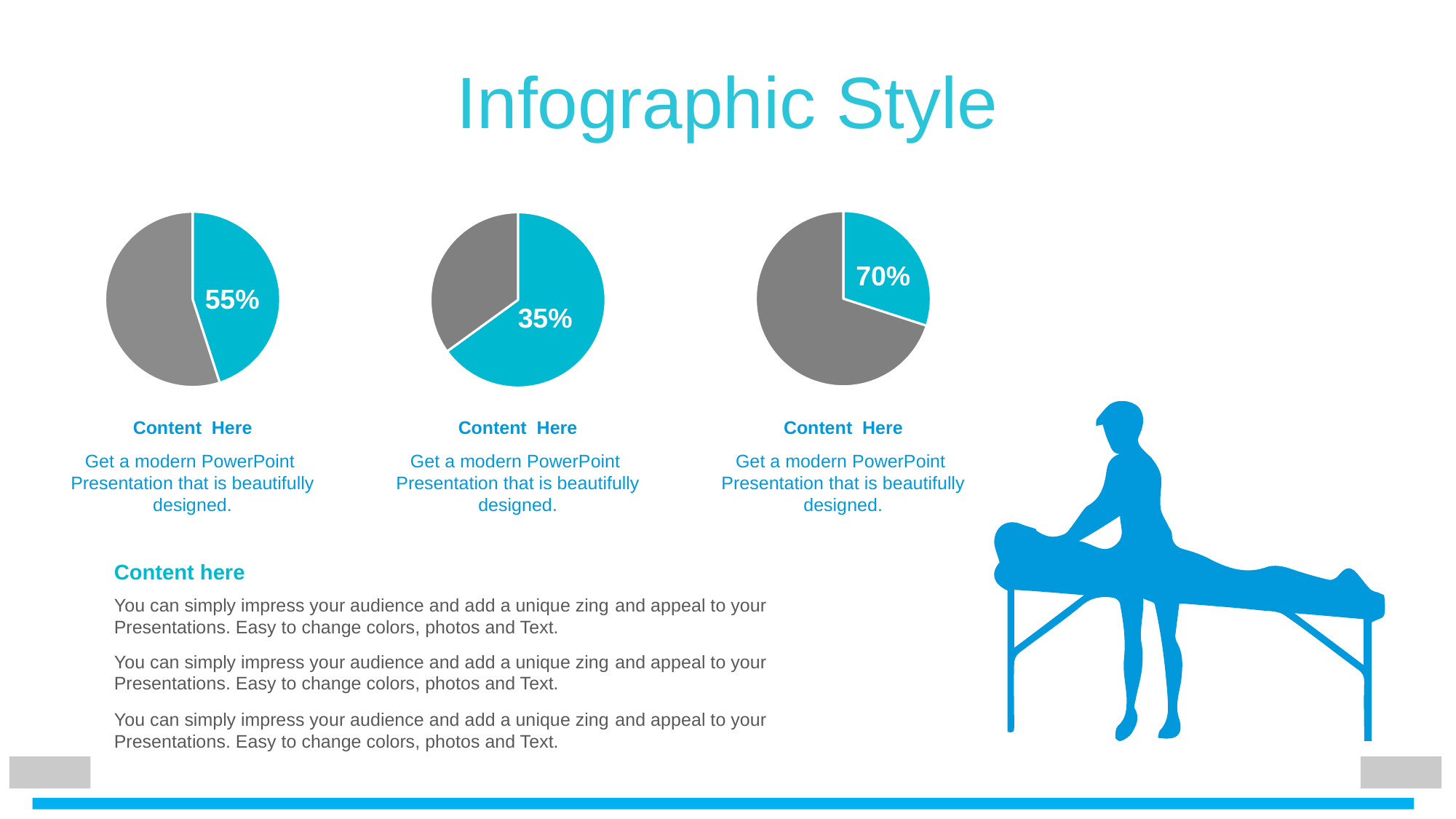
Is the labelled blue slice larger in the left pie chart or the middle pie chart? The left pie chart Which of the three pie charts has the smallest labelled blue slice? The middle pie chart (35%) What type of chart is used for the three charts on the slide? Pie chart How many pie charts are shown on the slide? 3 What colour is the labelled slice in each of the three pie charts? Blue What value is labelled on the blue slice of the right pie chart? 70% What is the difference between the labelled value in the left pie chart and the labelled value in the middle pie chart? 20% What is the difference between the labelled value in the right pie chart and the labelled value in the middle pie chart? 35% Which of the three pie charts has the largest labelled blue slice? The right pie chart (70%) What value is labelled on the blue slice of the left pie chart? 55% In the left pie chart, is the blue slice greater or less than 50% of the pie? greater What value is labelled on the blue slice of the middle pie chart? 35%